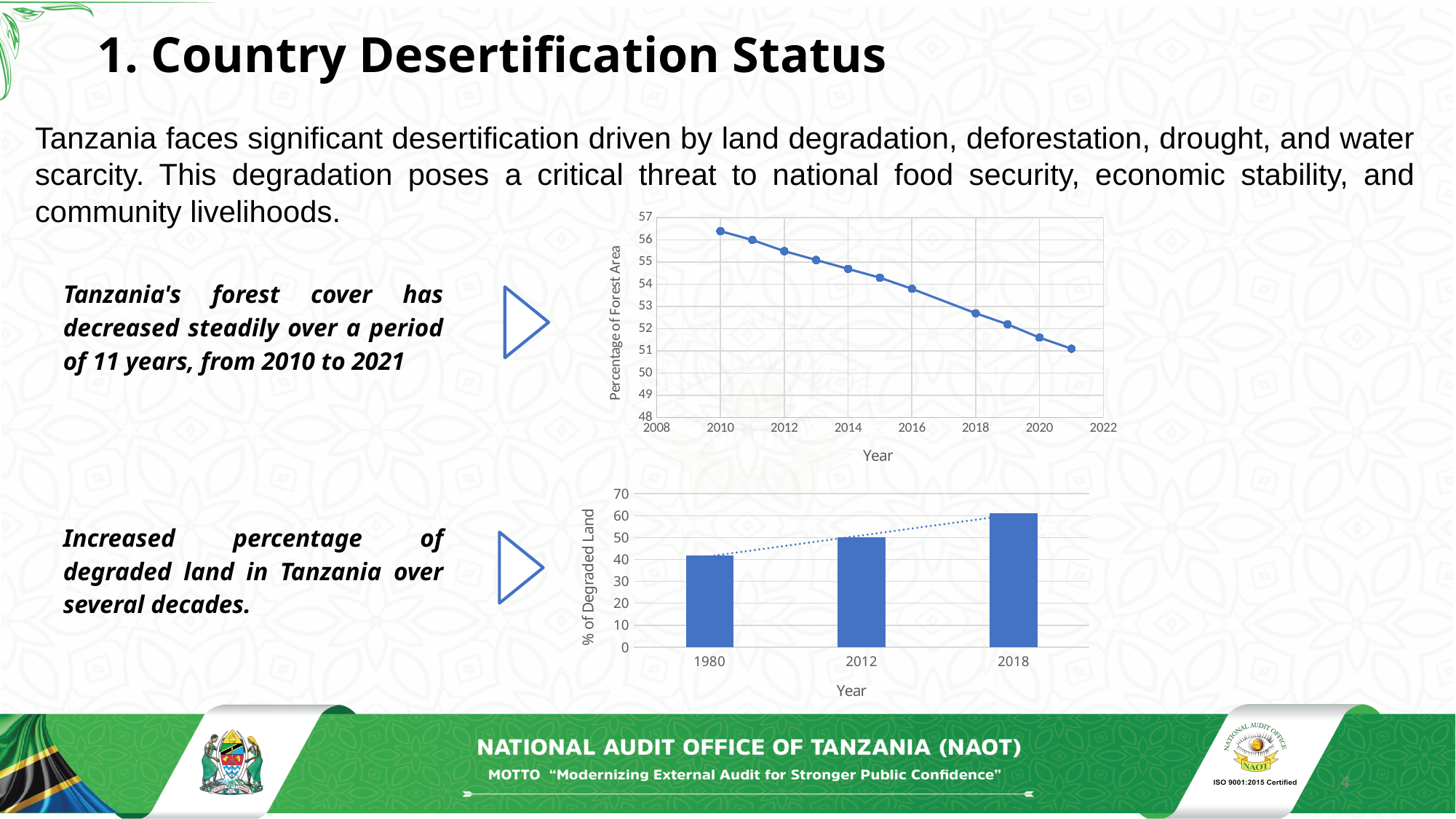
In the top chart (Percentage of Forest Area), is the value for 2021 greater or less than 52? less In the top chart (Percentage of Forest Area), is the value for 2010 greater or less than 56? greater In the top chart (Percentage of Forest Area), is the value for 2014 greater or less than 54? greater In the bottom chart (% of Degraded Land), which is larger, the value for 2012 or the value for 2018? 2018 In the bottom chart (% of Degraded Land), which year has the highest value? 2018 In the bottom chart (% of Degraded Land), which year has the lowest value? 1980 In the bottom chart (% of Degraded Land), how many bars are there? 3 In the top chart (Percentage of Forest Area), do the values rise or fall from 2010 to 2021? fall What kind of chart is the bottom chart on the slide (% of Degraded Land)? bar chart What kind of chart is the top chart on the slide (Percentage of Forest Area)? line chart How many data points are plotted in the top chart (Percentage of Forest Area)? 11